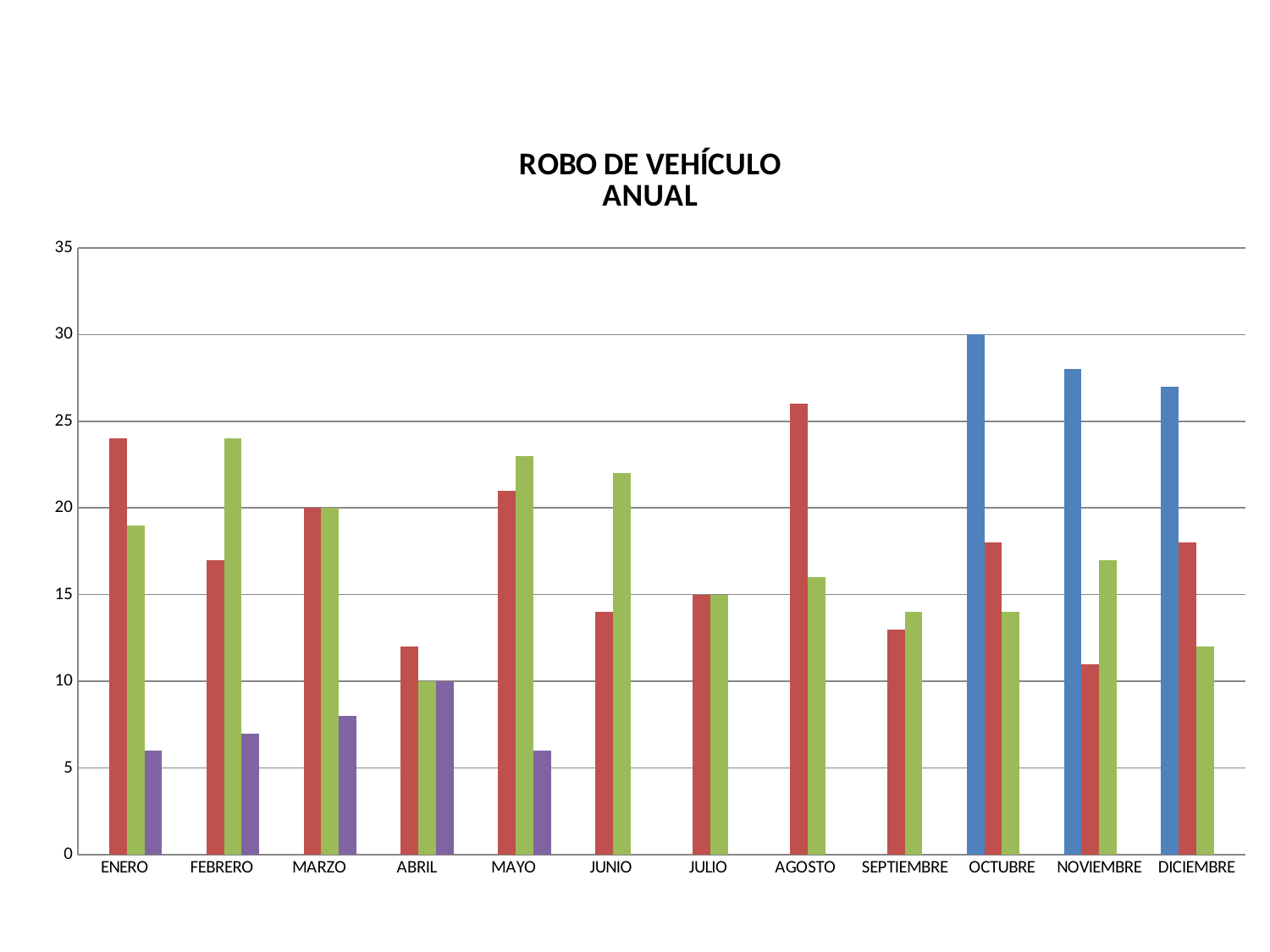
What kind of chart is shown on the slide? bar chart Which month has the tallest bar in the chart? OCTUBRE What is the title of the chart? ROBO DE VEHÍCULO ANUAL How many months are shown on the x axis? 12 Is the value of the red bar for ENERO greater or less than 20? greater What is the value of the red bar for JULIO? 15 Which is larger, the red bar for AGOSTO or the red bar for SEPTIEMBRE? AGOSTO What is the value of the blue bar for OCTUBRE? 30 What is the value of the green bar for MARZO? 20 Is the value of the purple bar for FEBRERO greater or less than 10? less What is the difference between the red bar for MARZO and the red bar for JULIO? 5 What is the value of the purple bar for ABRIL? 10